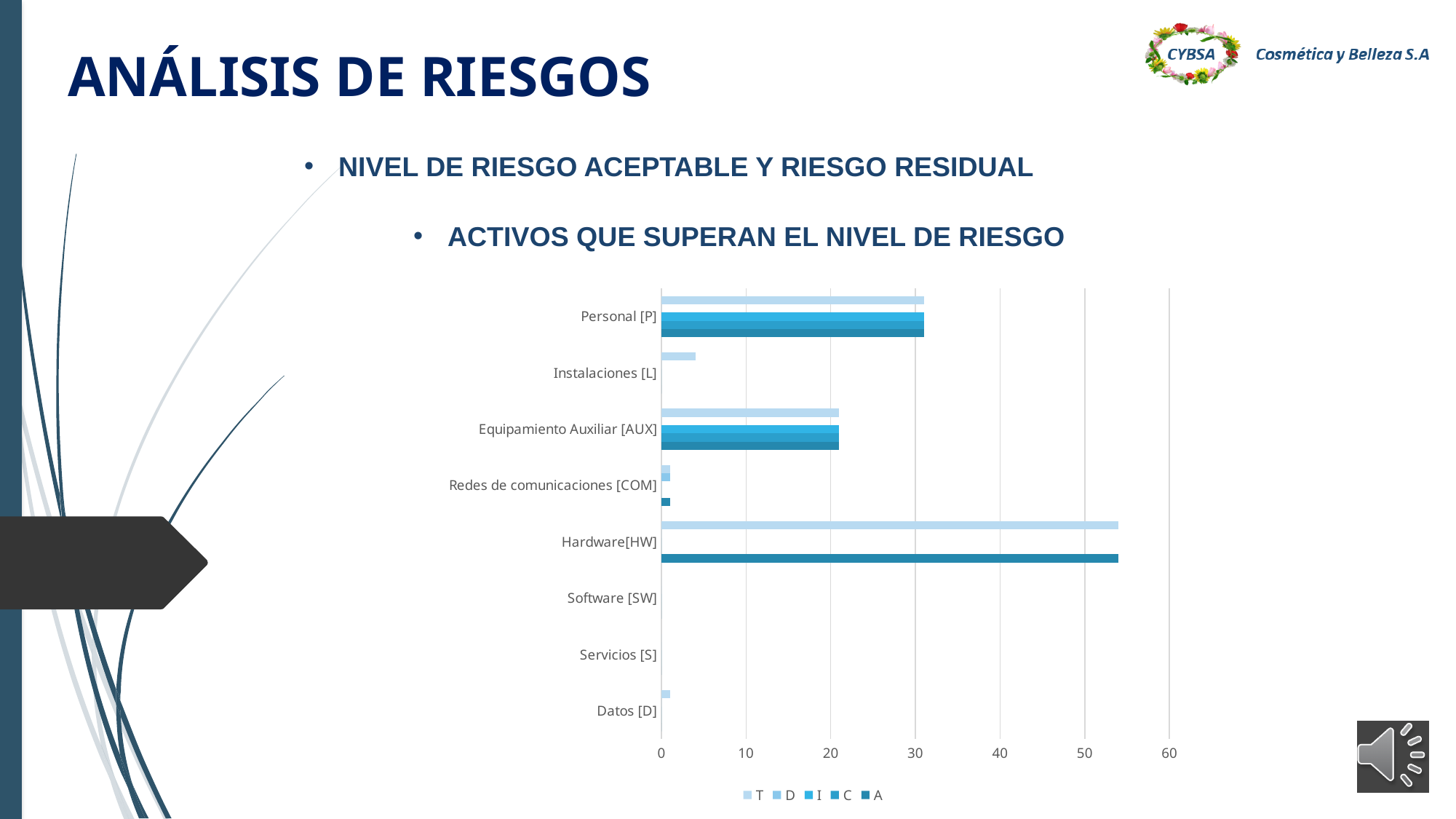
How many categories are listed on the vertical axis of the chart? 8 Which has a larger T value, Hardware[HW] or Personal [P]? Hardware[HW] What kind of chart is shown on the slide? bar chart Which category has the longest bar in the chart? Hardware[HW] Is the value of the T series for Equipamiento Auxiliar [AUX] greater or less than 30? less Is the value of the T series for Personal [P] greater or less than 20? greater Is the value of the T series for Hardware[HW] greater or less than 50? greater Which has a larger T value, Personal [P] or Equipamiento Auxiliar [AUX]? Personal [P] How many series does the chart legend list? 5 What are the legend entries of the chart? T, D, I, C, A What is the highest value shown on the horizontal axis of the chart? 60